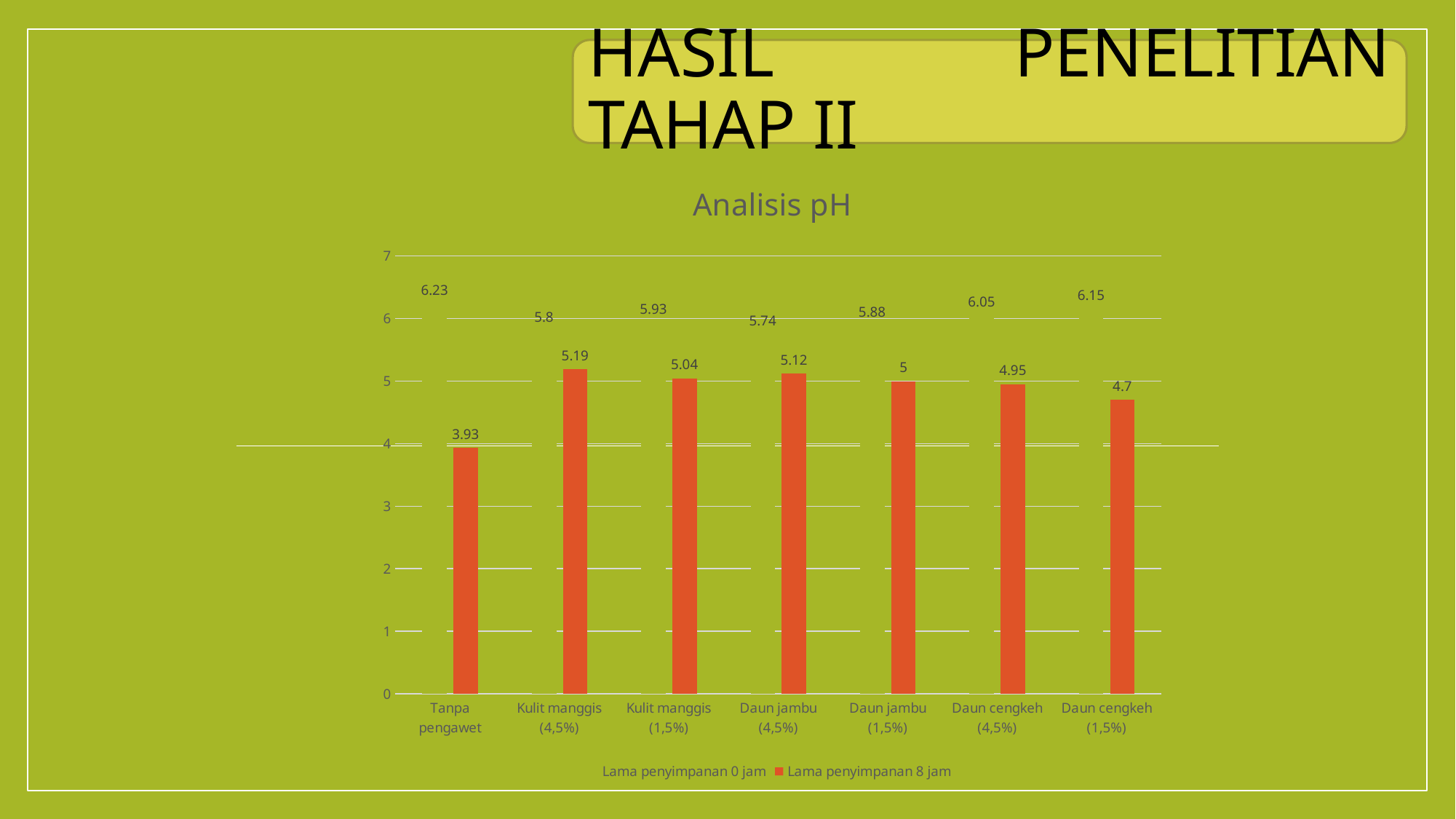
What type of chart is shown? Bar chart Which category has the highest value for Lama penyimpanan 8 jam? Kulit manggis (4,5%) How many categories are shown on the x axis? 7 Which category has the lowest value for Lama penyimpanan 8 jam? Tanpa pengawet What is the value for Lama penyimpanan 0 jam for Tanpa pengawet? 6.23 Which is larger for Lama penyimpanan 8 jam: Kulit manggis (1,5%) or Daun cengkeh (4,5%)? Kulit manggis (1,5%) Which category has the highest value for Lama penyimpanan 0 jam? Tanpa pengawet How many series does the legend list? 2 What is the value for Lama penyimpanan 8 jam for Tanpa pengawet? 3.93 What is the value for Lama penyimpanan 0 jam for Daun jambu (4,5%)? 5.74 What is the difference between the Lama penyimpanan 0 jam and Lama penyimpanan 8 jam values for Tanpa pengawet? 2.3 What is the value for Lama penyimpanan 8 jam for Daun cengkeh (1,5%)? 4.7